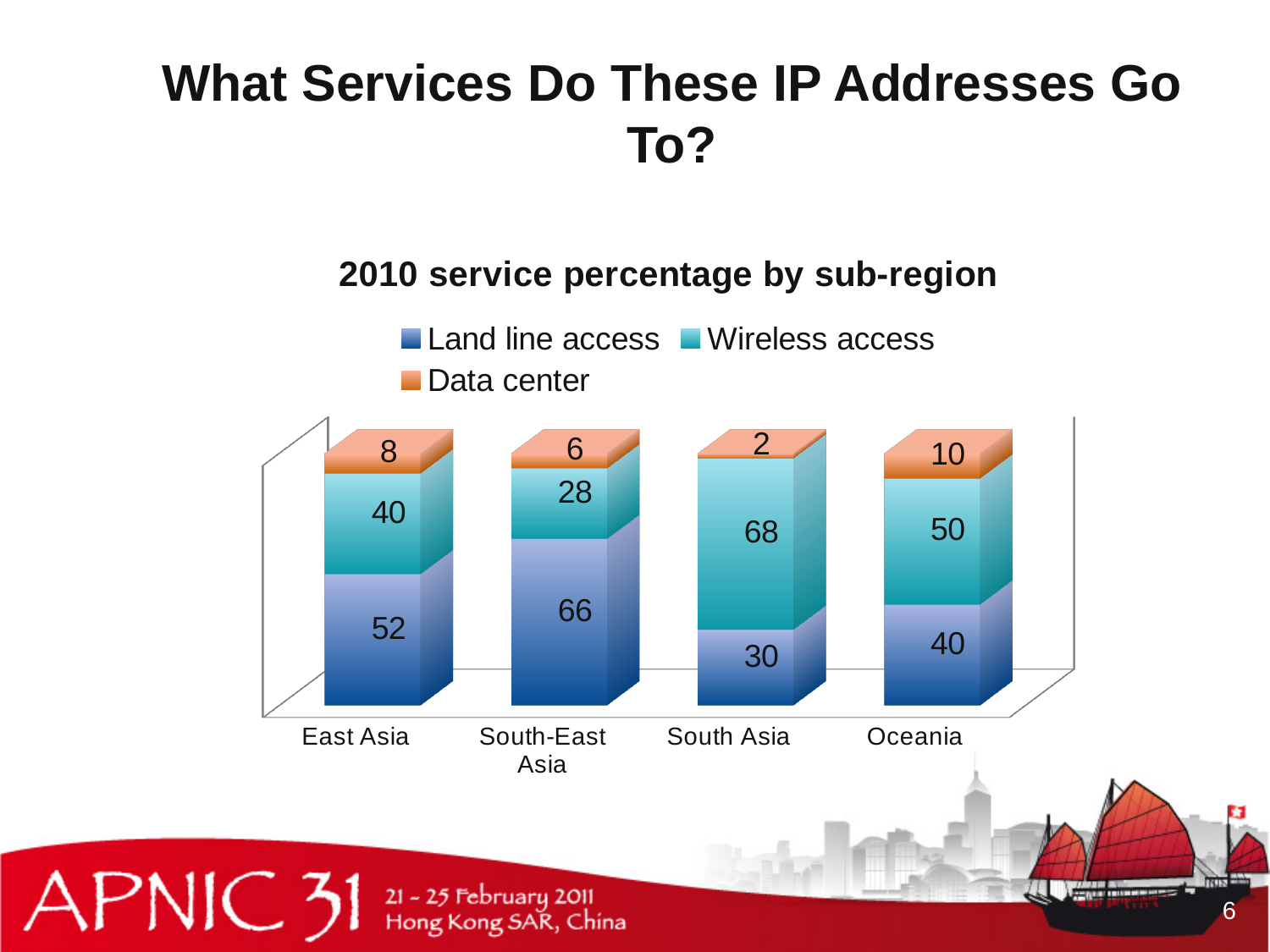
Which sub-region has the lowest Data center value? South Asia What is the Data center value for Oceania? 10 How many series does the legend list? 3 What kind of chart is shown on the slide? Stacked bar chart What is the total of the stacked bar for East Asia? 100 Which sub-region has the highest Wireless access value? South Asia What is the title of the chart? 2010 service percentage by sub-region What is the Land line access value for South-East Asia? 66 How many sub-regions are shown on the x axis? 4 What is the Wireless access value for South Asia? 68 Which is larger: the Wireless access value for East Asia or for Oceania? Oceania What is the difference between the Land line access values for South-East Asia and South Asia? 36